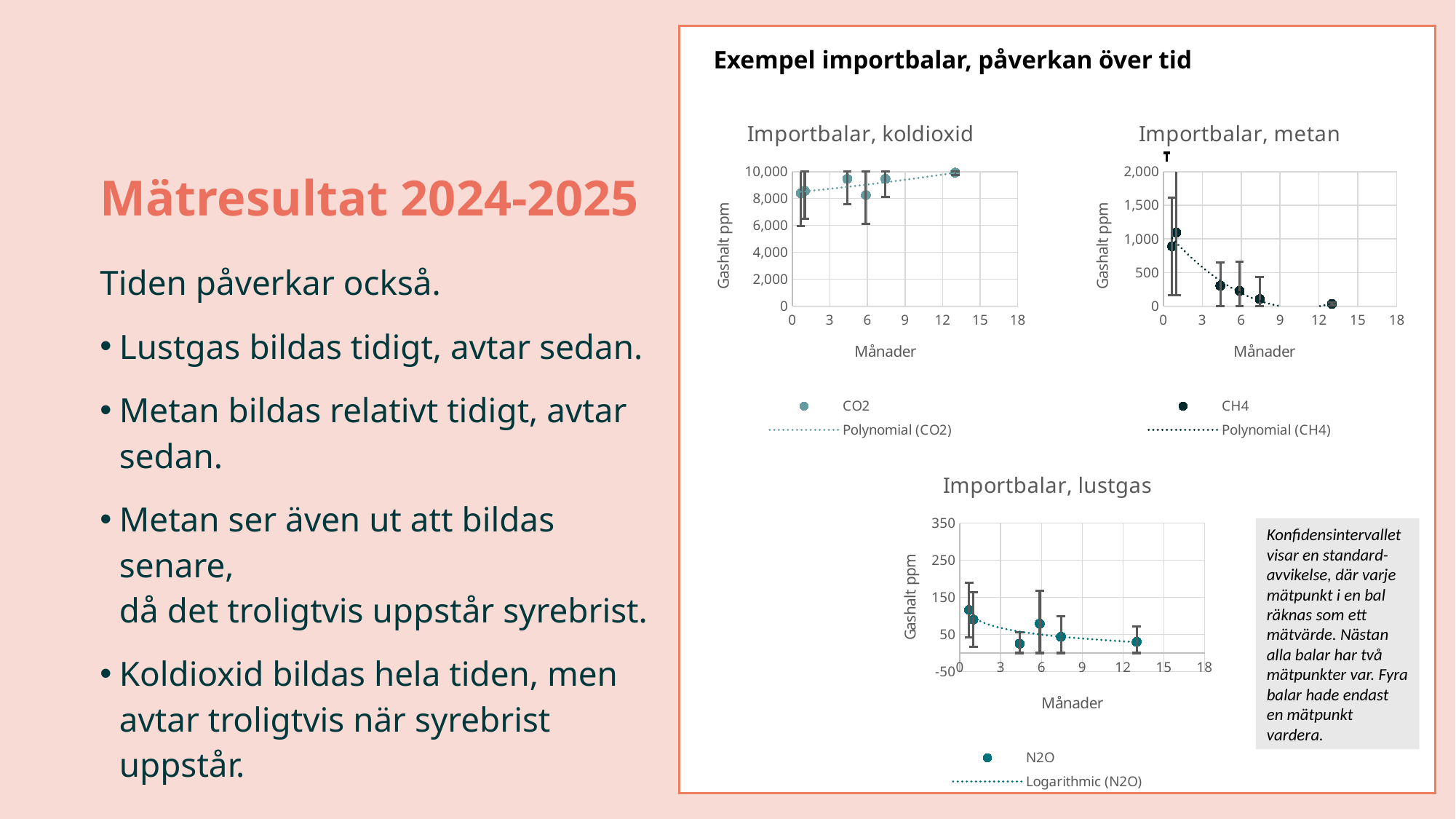
In the "Importbalar, lustgas" chart, is the value of the rightmost N2O point (at about 13 months) greater or less than 150? less What type of trendline is listed in the legend of the "Importbalar, lustgas" chart? Logarithmic (N2O) In the "Importbalar, metan" chart, do the CH4 values rise or fall as the months increase? fall In the "Importbalar, metan" chart, is the value of the rightmost CH4 point (at about 13 months) greater or less than 500? less In the "Importbalar, metan" chart, which is larger: the CH4 value of the first point (near 1 month) or the last point (near 13 months)? the first point In the "Importbalar, koldioxid" chart, do the CO2 values rise or fall as the months increase? rise In the "Importbalar, koldioxid" chart, is the value of the rightmost CO2 point (at about 13 months) greater or less than 6,000? greater What is the y-axis label on the "Importbalar, metan" chart? Gashalt ppm How many entries does the legend of the "Importbalar, lustgas" chart list? 2 In the "Importbalar, lustgas" chart, do the N2O values rise or fall as the months increase? fall What kind of chart is "Importbalar, koldioxid"? scatter chart